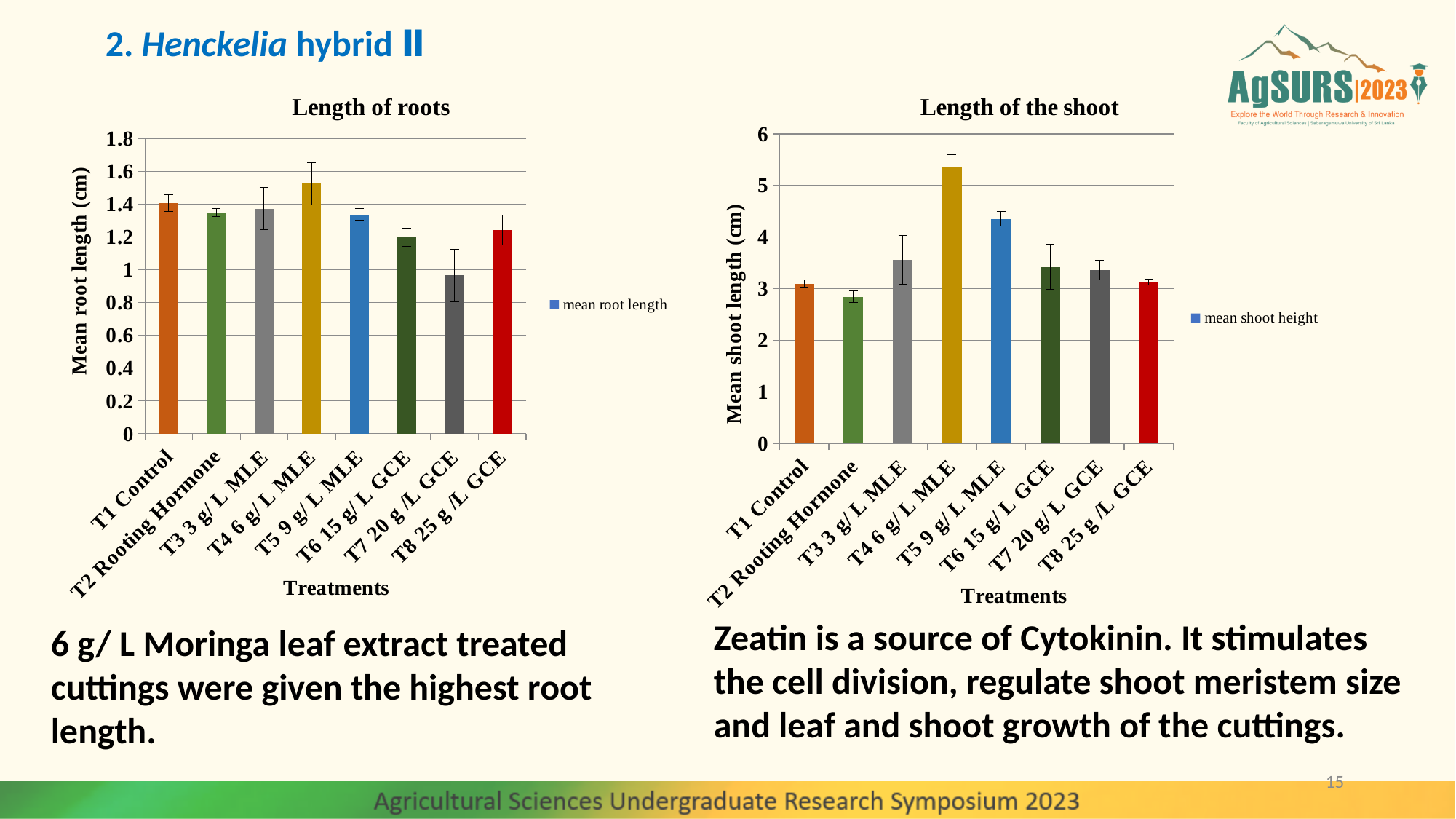
In the 'Length of roots' chart, which treatment has the lowest mean root length? T7 20 g/L GCE In the 'Length of roots' chart, is the value for T4 6 g/L MLE greater or less than 1.4? greater How many series does the legend of the 'Length of the shoot' chart list? 1 In the 'Length of roots' chart, which treatment has the highest mean root length? T4 6 g/L MLE In the 'Length of the shoot' chart, which treatment has the lowest mean shoot length? T2 Rooting Hormone In the 'Length of the shoot' chart, is the value for T4 6 g/L MLE greater or less than 5? greater In the 'Length of roots' chart, how many treatments are plotted? 8 In the 'Length of roots' chart, is the value for T7 20 g/L GCE greater or less than 1? less In the 'Length of the shoot' chart, which is larger, the value for T5 9 g/L MLE or T6 15 g/L GCE? T5 9 g/L MLE In the 'Length of the shoot' chart, which treatment has the highest mean shoot length? T4 6 g/L MLE What kind of chart is the 'Length of roots' chart? bar chart